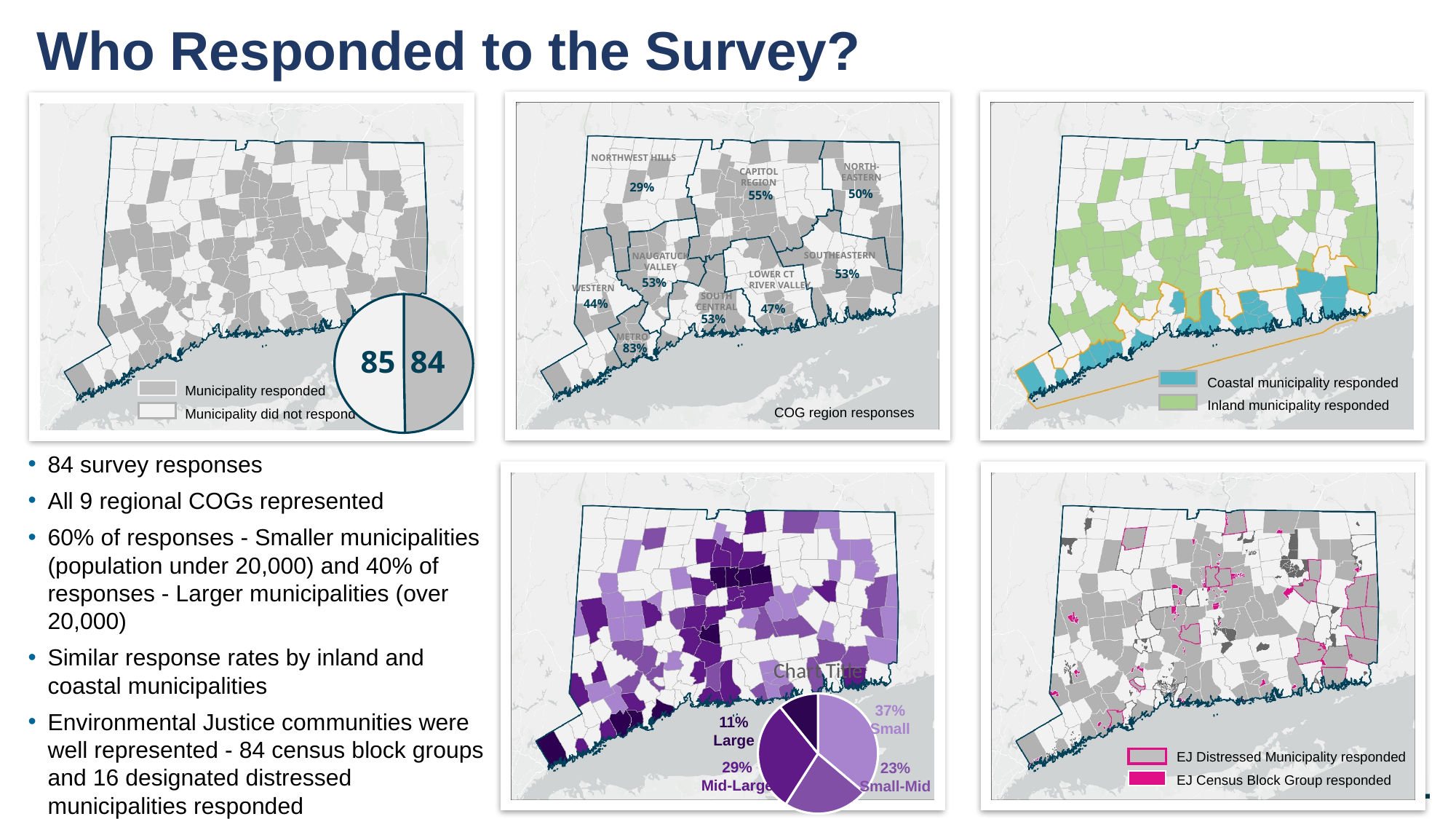
In the bottom-middle pie chart, which municipality size category has the smallest share? Large In the bottom-middle pie chart, what share of responses came from Large municipalities? 11% In the bottom-middle pie chart, which municipality size category has the largest share? Small What title is printed above the bottom-middle pie chart? Chart Title In the top-left pie chart, what value is shown for the grey 'Municipality responded' slice? 84 In the bottom-middle pie chart, what share of responses came from Small municipalities? 37% In the bottom-middle pie chart, which is larger: the Small-Mid share or the Mid-Large share? Mid-Large In the top-left pie chart, what value is shown for the white 'Municipality did not respond' slice? 85 In the bottom-middle pie chart, how many slices are there? 4 In the bottom-middle pie chart, what share of responses came from Mid-Large municipalities? 29% What kind of chart is shown in the bottom-middle panel below the purple map? pie chart In the bottom-middle pie chart, what is the difference in percentage points between the Small and Large shares? 26